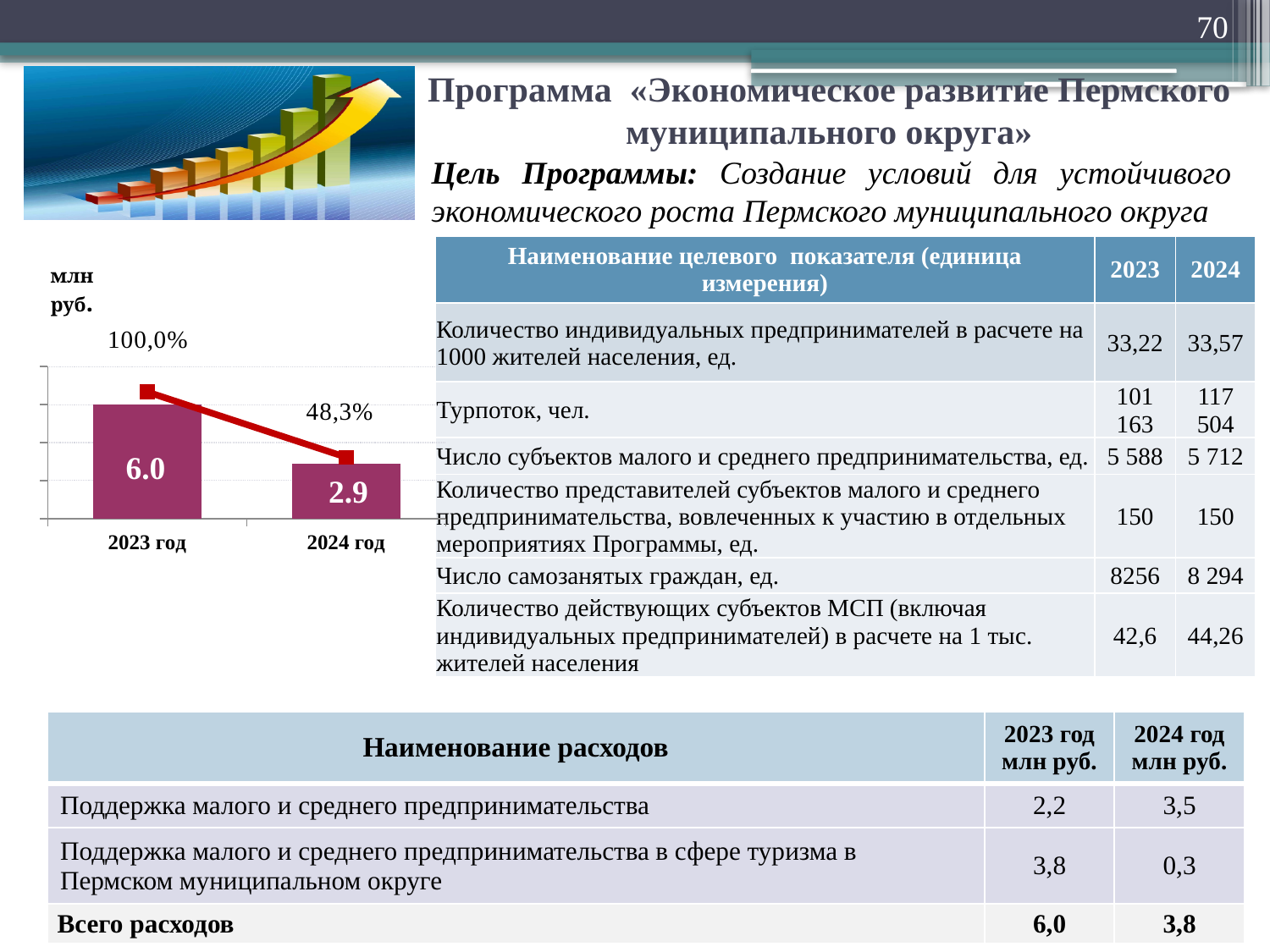
Which year has the highest bar in the chart? 2023 год What unit label is shown at the top left of the chart? млн руб. What kind of chart is shown on the left of the slide? combination bar and line chart What percentage label is shown above the 2024 год point on the line in the chart? 48,3% How many years (categories) are shown on the x axis of the chart? 2 What is the value of the bar for 2024 год in the chart? 2.9 Do the bar values rise or fall from 2023 год to 2024 год in the chart? fall What is the difference between the bar values for 2023 год and 2024 год in the chart? 3.1 What percentage label is shown above the 2023 год point on the line in the chart? 100,0% What is the value of the bar for 2023 год in the chart? 6.0 Which year has the lowest bar in the chart? 2024 год Which is larger in the chart, the bar for 2023 год or the bar for 2024 год? 2023 год